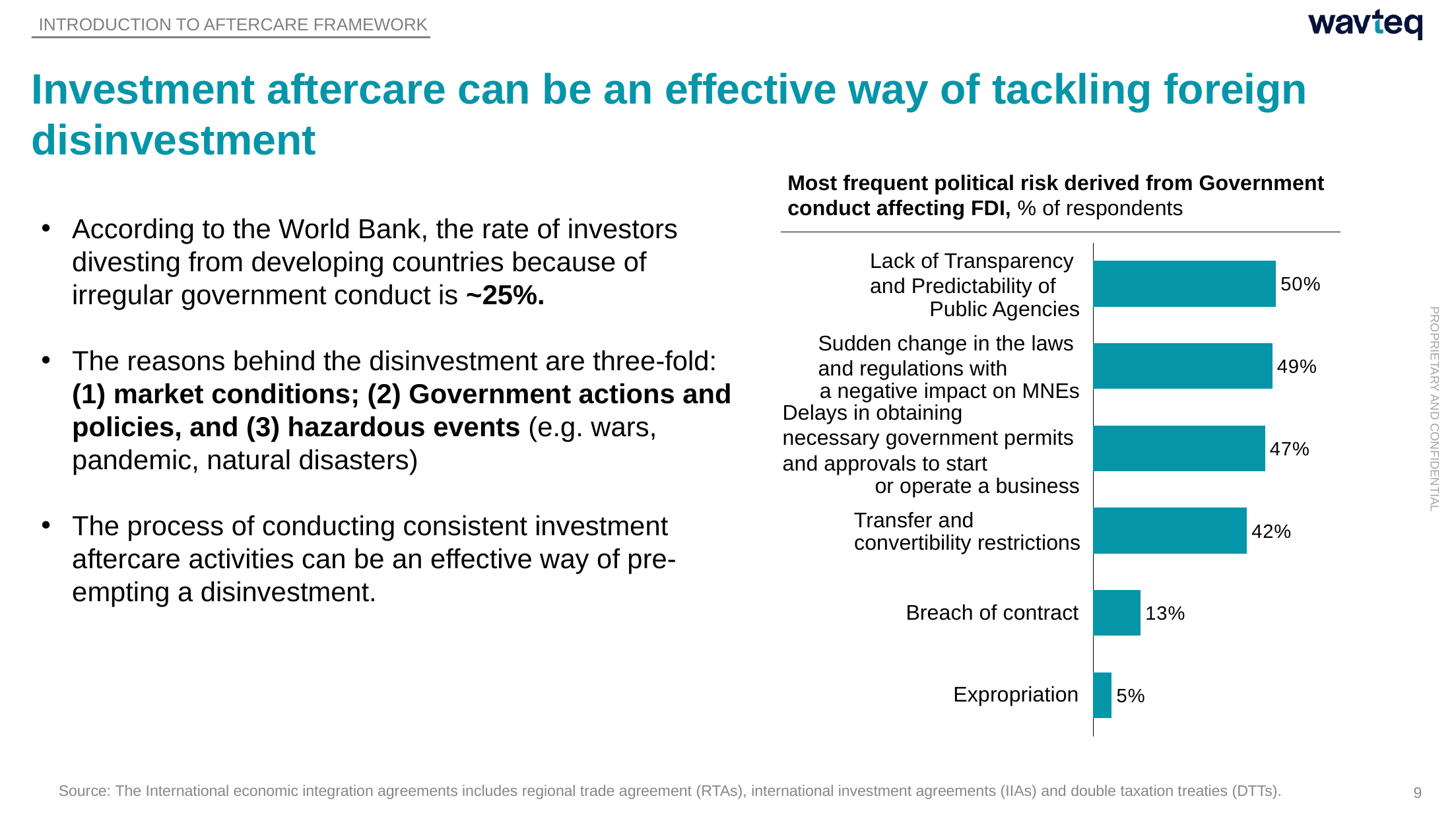
Which is larger: the value for Breach of contract or the value for Expropriation? Breach of contract What is the difference between the values for Delays in obtaining necessary government permits and approvals to start or operate a business and Expropriation? 42% What percentage of respondents cited Lack of Transparency and Predictability of Public Agencies? 50% What is the value for Transfer and convertibility restrictions? 42% What kind of chart is shown on the slide? Bar chart What is the difference between the values for Transfer and convertibility restrictions and Breach of contract? 29% Which category has the highest value? Lack of Transparency and Predictability of Public Agencies What unit are the chart values expressed in, according to the chart title? % of respondents What is the value for Breach of contract? 13% What is the value for Sudden change in the laws and regulations with a negative impact on MNEs? 49% Which category has the lowest value? Expropriation How many categories are shown in the chart? 6